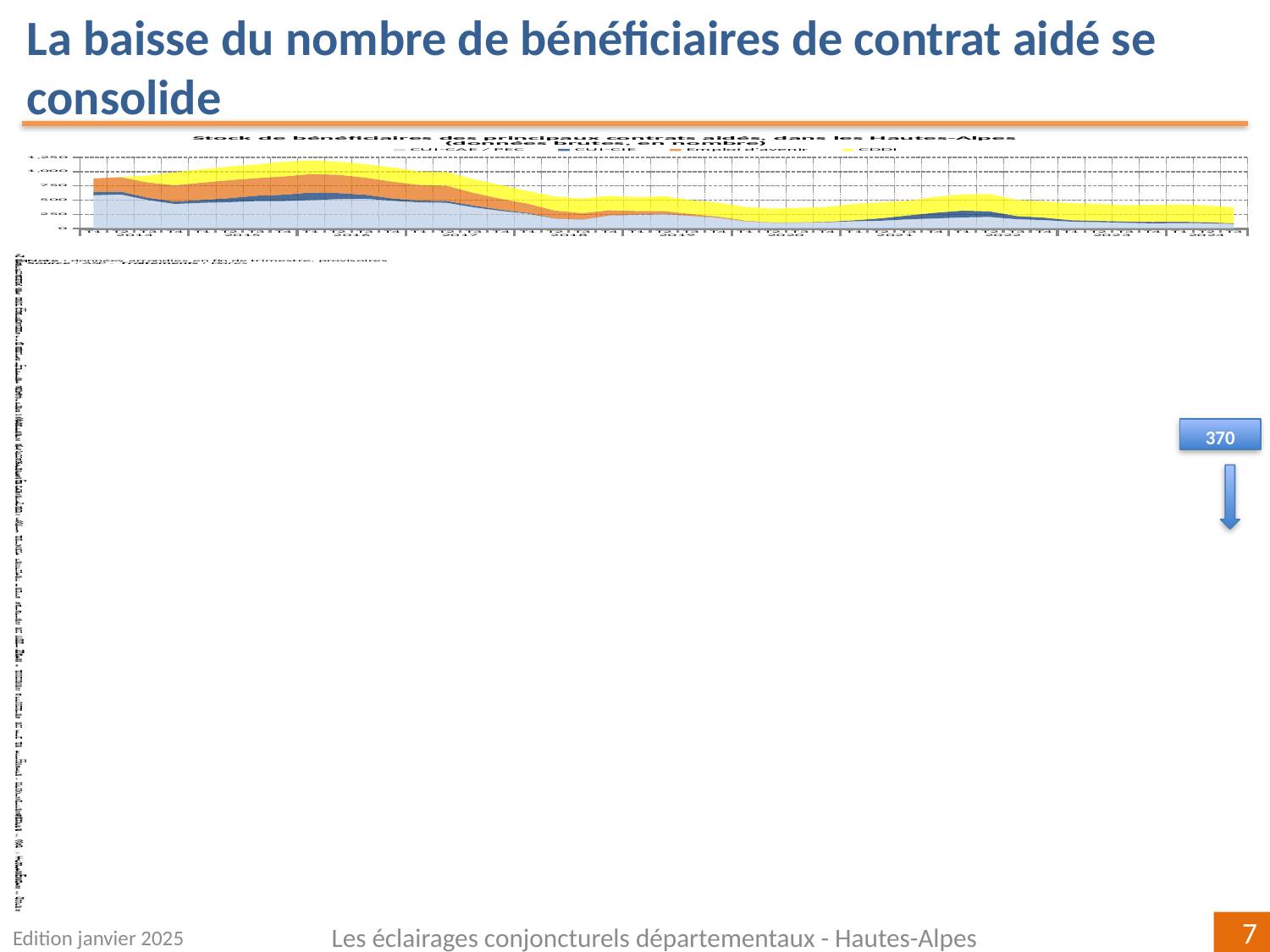
Overall, does the total stock of beneficiaries rise or fall between 2016 and 2024? Fall How many years are labelled along the x axis of the chart? 11 What kind of chart is shown on the slide? Stacked area chart Is the total stock of beneficiaries in 2016 greater or less than 750? greater In which year does the total stock of beneficiaries reach its highest level? 2016 Which year is the first labelled on the x axis of the chart? 2014 Is the total stock of beneficiaries in 2024 greater or less than 500? less How many series does the legend of the chart list? 4 Which series are listed in the chart's legend? CUI-CAE / PEC, CUI-CIE, Emploi d'avenir, CDDI Which series is shown in yellow in the chart? CDDI Which year is the last labelled on the x axis of the chart? 2024 What is the highest value shown on the y axis of the chart? 1 250